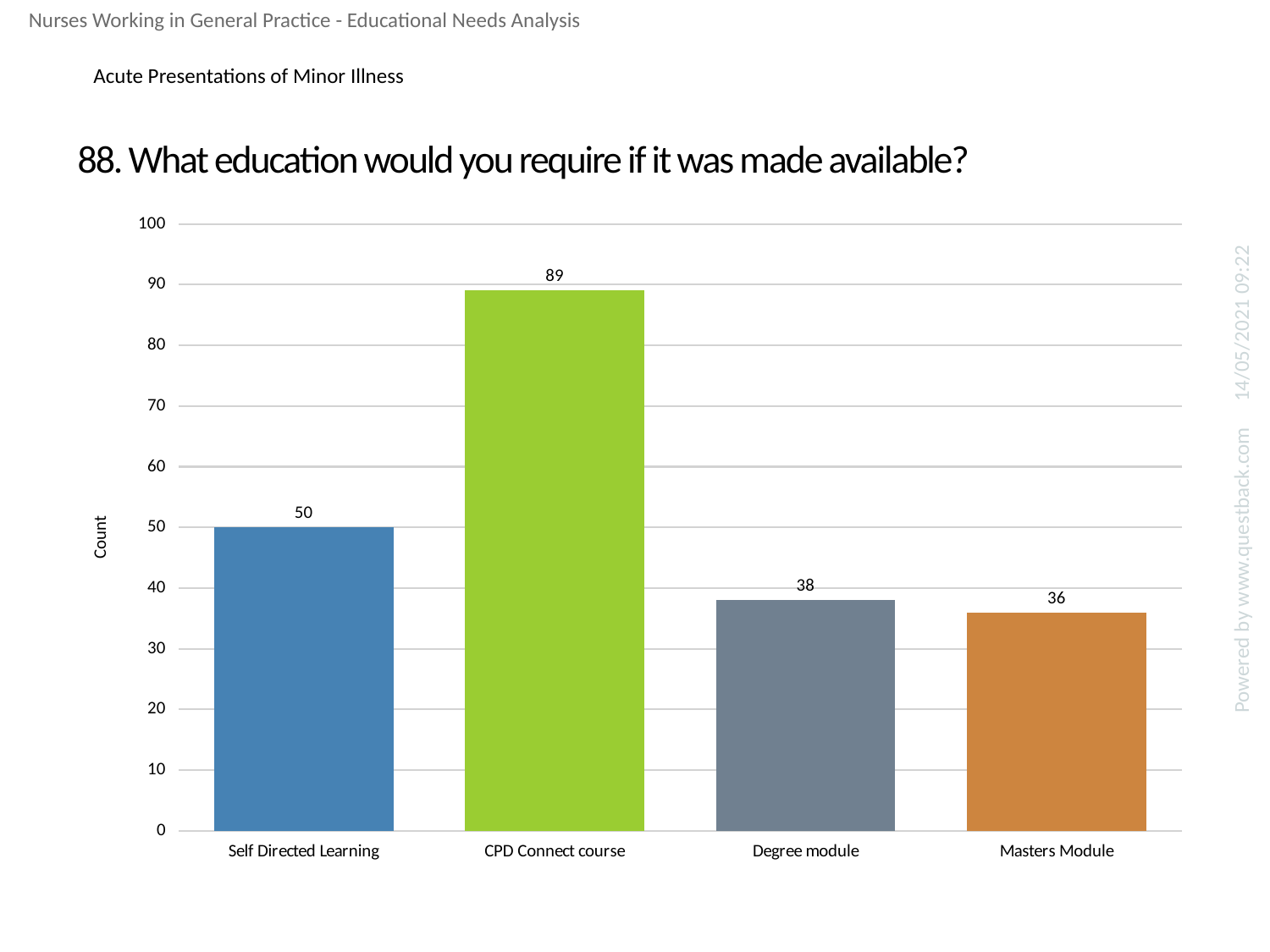
How many categories are shown on the x axis? 4 What kind of chart is shown on the slide? bar chart What is the count for Self Directed Learning? 50 What is the label of the y axis? Count Is the value for Degree module greater or less than 40? less Which category has the highest count? CPD Connect course Which category has the lowest count? Masters Module What is the count for CPD Connect course? 89 What is the count for Masters Module? 36 Which has a larger count, Self Directed Learning or Degree module? Self Directed Learning What is the difference between the counts for CPD Connect course and Self Directed Learning? 39 What is the difference between the counts for Degree module and Masters Module? 2